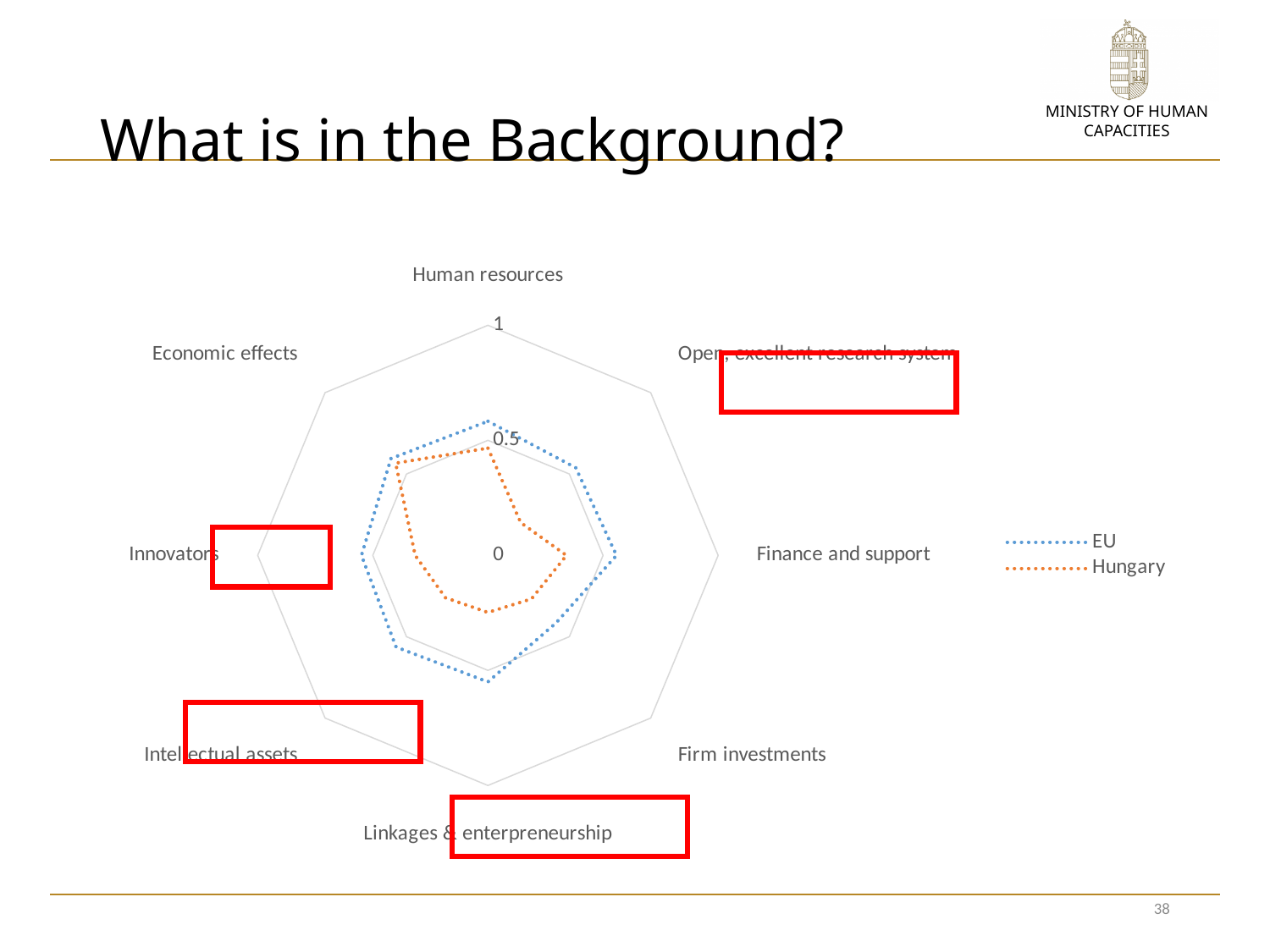
For Linkages & enterpreneurship, which series has the larger value, EU or Hungary? EU Is the EU value for Human resources greater or less than 1? less How many series does the chart legend list? 2 Which series is drawn with the orange dotted line? Hungary How many categories (axes) does the radar chart have? 8 What kind of chart is shown on the slide? Radar chart Which series is drawn with the blue dotted line? EU Is the Hungary value for Finance and support greater or less than 0.5? less For Firm investments, which series has the larger value, EU or Hungary? EU Is the Hungary value for Firm investments greater or less than 0.5? less For Finance and support, which series has the larger value, EU or Hungary? EU